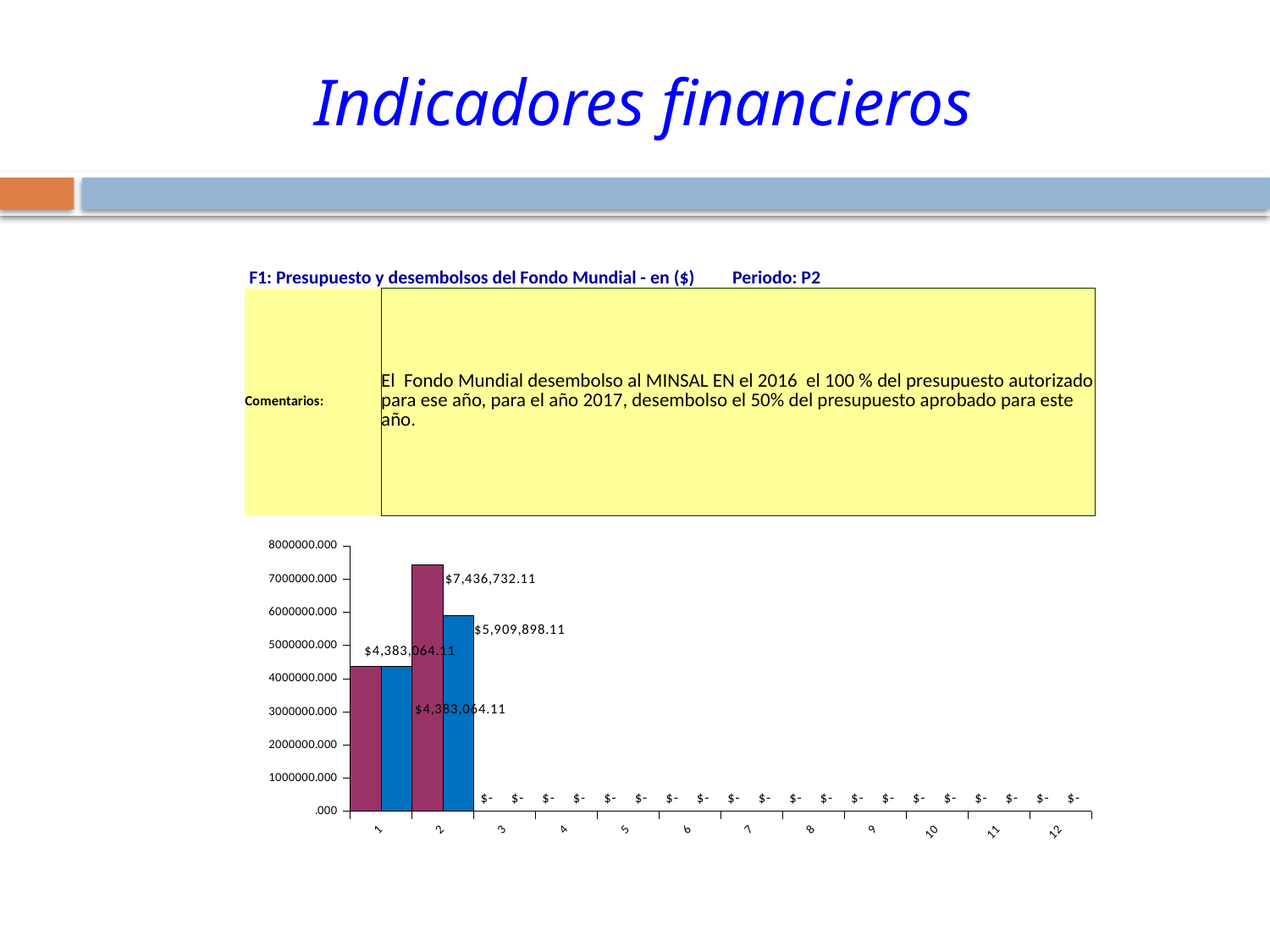
How many categories are shown on the x axis of the chart? 12 What is the value of the blue bar for category 2? $5,909,898.11 How many categories on the x axis show a value of $-? 10 For category 2, which bar is larger, the purple one or the blue one? purple What is the title printed above the comments box on the slide? F1: Presupuesto y desembolsos del Fondo Mundial - en ($) Which category has the highest value in the chart? 2 What is the difference between the purple bar and the blue bar for category 2? $1,526,834.00 Is the value of the purple bar for category 2 greater or less than 7000000? greater What is the value of the tallest purple bar in the chart (category 2)? $7,436,732.11 What kind of chart is shown on the slide? bar chart What is the difference between the purple bar for category 2 ($7,436,732.11) and the purple bar for category 1 ($4,383,064.11)? $3,053,668.00 What is the value of the purple bar for category 1? $4,383,064.11